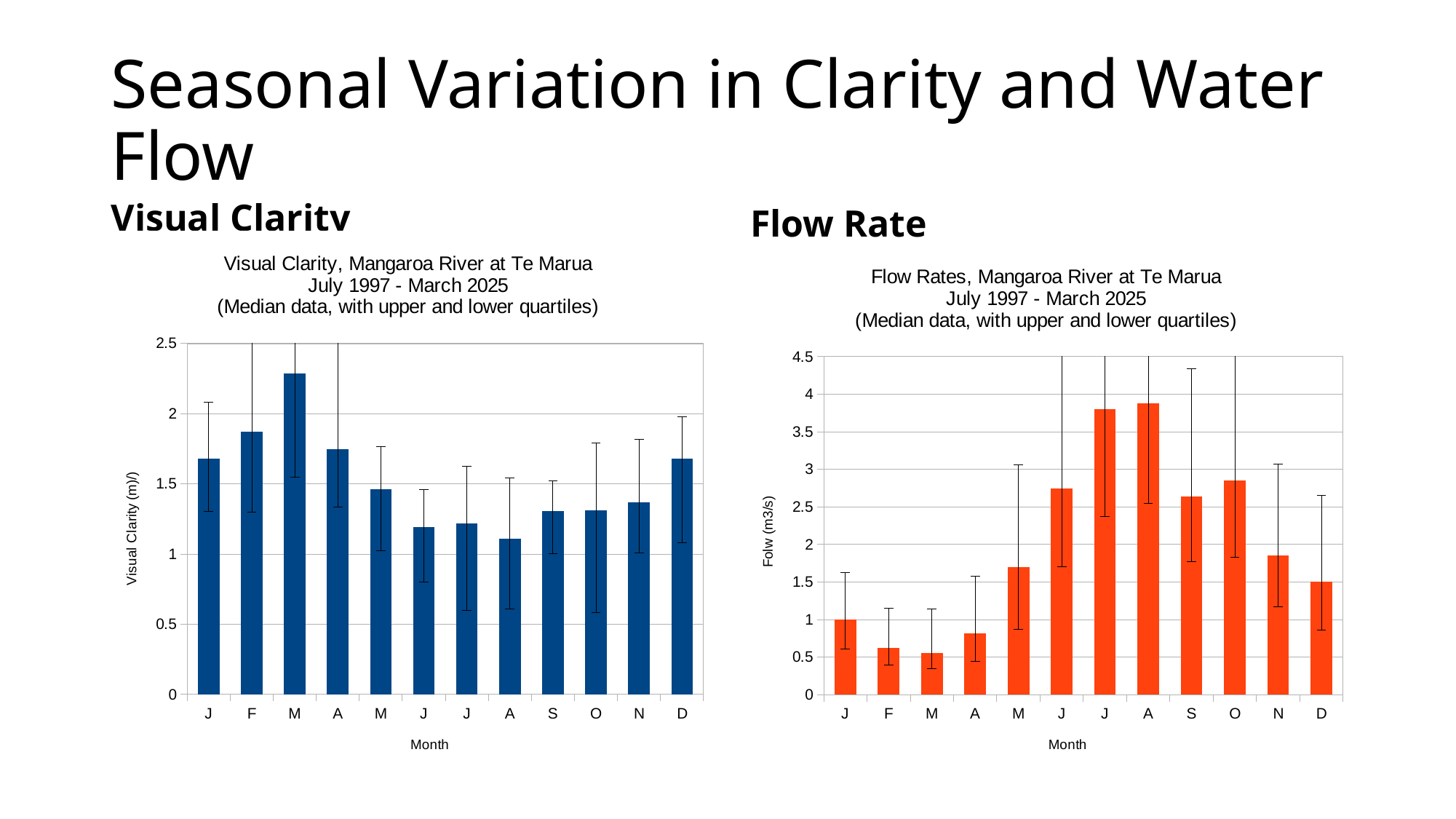
On the Flow Rate chart, do the values generally rise or fall from the first month J through to the eighth month A? rise On the Visual Clarity chart, which month has the lowest median visual clarity? A (August, the eighth bar) On the Visual Clarity chart, is the value for F greater or less than 1.5? greater What kind of chart is the Visual Clarity chart on the left? bar chart On the Visual Clarity chart, which month has the highest median visual clarity? M (March, the third bar) On the Visual Clarity chart, is the value for S greater or less than 1.5? less What is the y-axis label on the Flow Rate chart? Folw (m3/s) How many months (bars) are plotted on the Flow Rate chart on the right? 12 On the Flow Rate chart, is the value for D greater or less than 2? less On the Visual Clarity chart, which is larger, the value for F or the value for D? F On the Flow Rate chart, which is larger, the value for O or the value for N? O